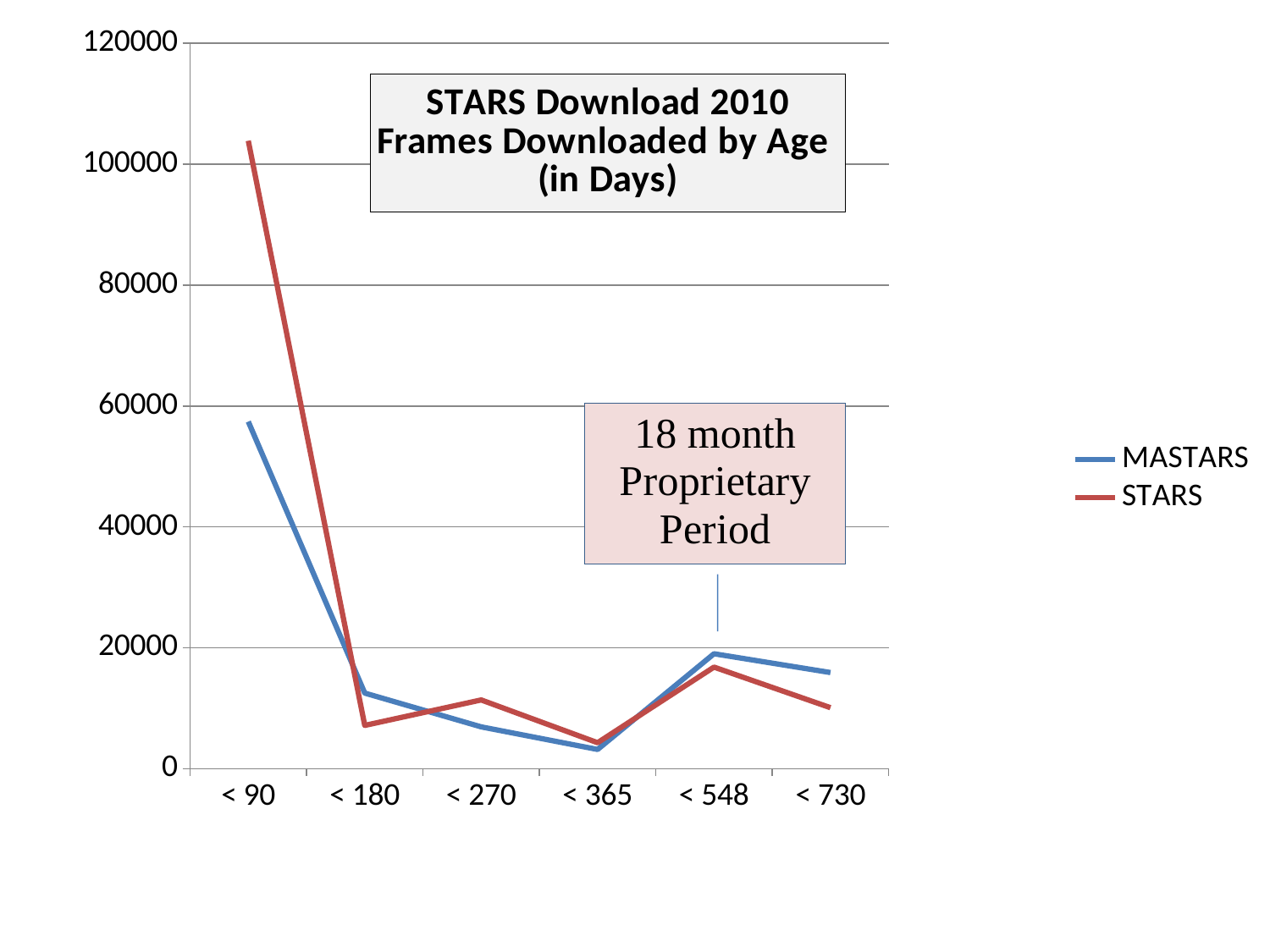
At the < 730 category, which series has the larger value, MASTARS or STARS? MASTARS Is the STARS value for < 90 greater or less than 80000? greater Is the MASTARS value for < 90 greater or less than 40000? greater At the < 90 category, which series has the larger value, MASTARS or STARS? STARS For which age category is the MASTARS value highest? < 90 What kind of chart is shown on the slide? line chart For which age category is the STARS value highest? < 90 What is the title of the chart? STARS Download 2010 Frames Downloaded by Age (in Days) For which age category is the STARS value lowest? < 365 How many age categories are plotted along the x axis? 6 For which age category is the MASTARS value lowest? < 365 How many series does the legend list? 2